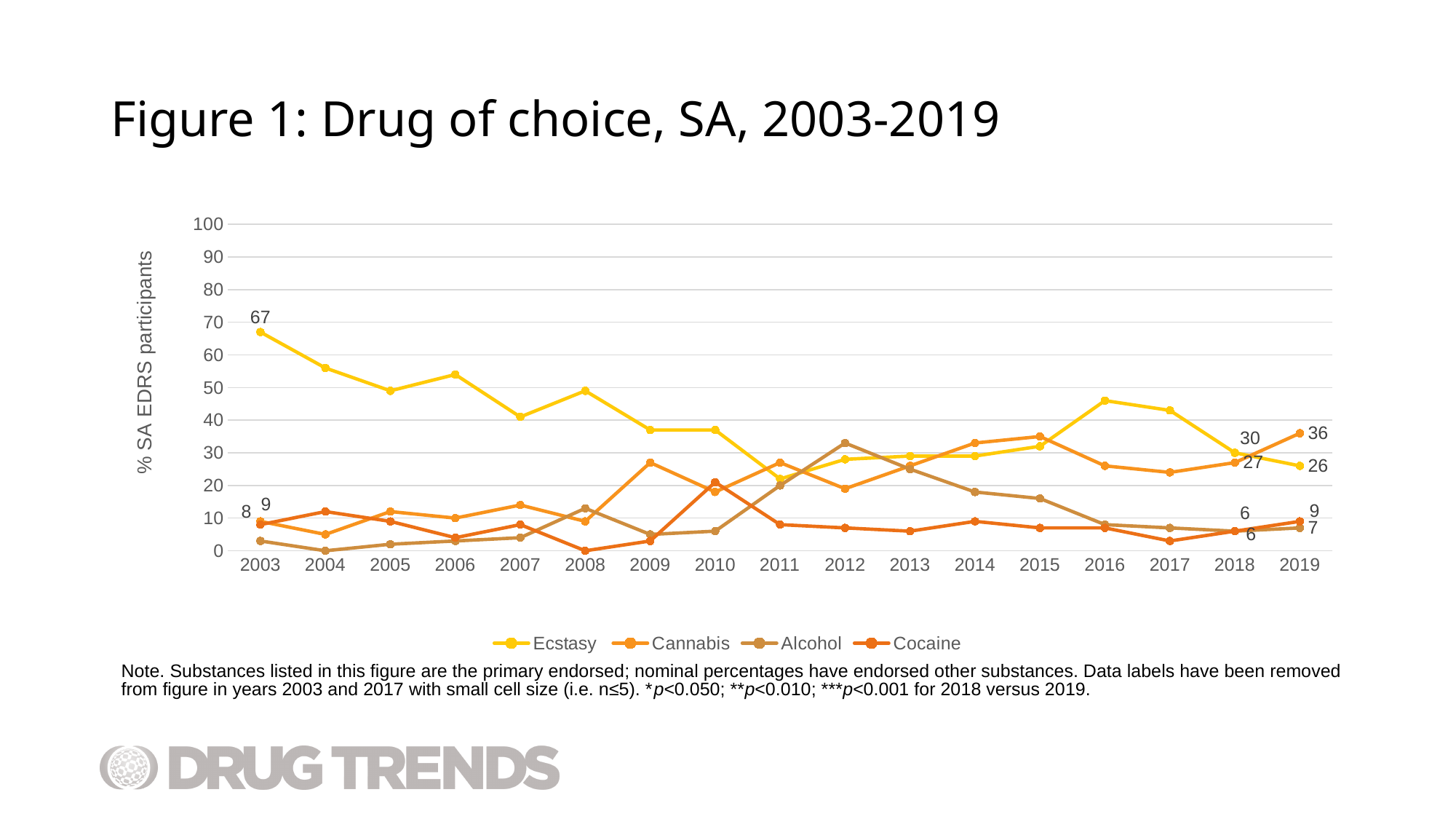
Does the Ecstasy line rise or fall overall from 2003 to 2019? Fall What is the difference between the Cannabis and Ecstasy values in 2019? 10 What kind of chart is shown on the slide? Line chart How many series does the legend list? 4 Which series has the highest value in 2019? Cannabis How many years are shown on the x axis? 17 What is the value for Ecstasy in 2003? 67 What is the value for Ecstasy in 2018? 30 What is the value for Cannabis in 2018? 27 Is the value for Ecstasy in 2004 greater or less than 50? greater What is the value for Ecstasy in 2019? 26 What is the value for Cannabis in 2019? 36